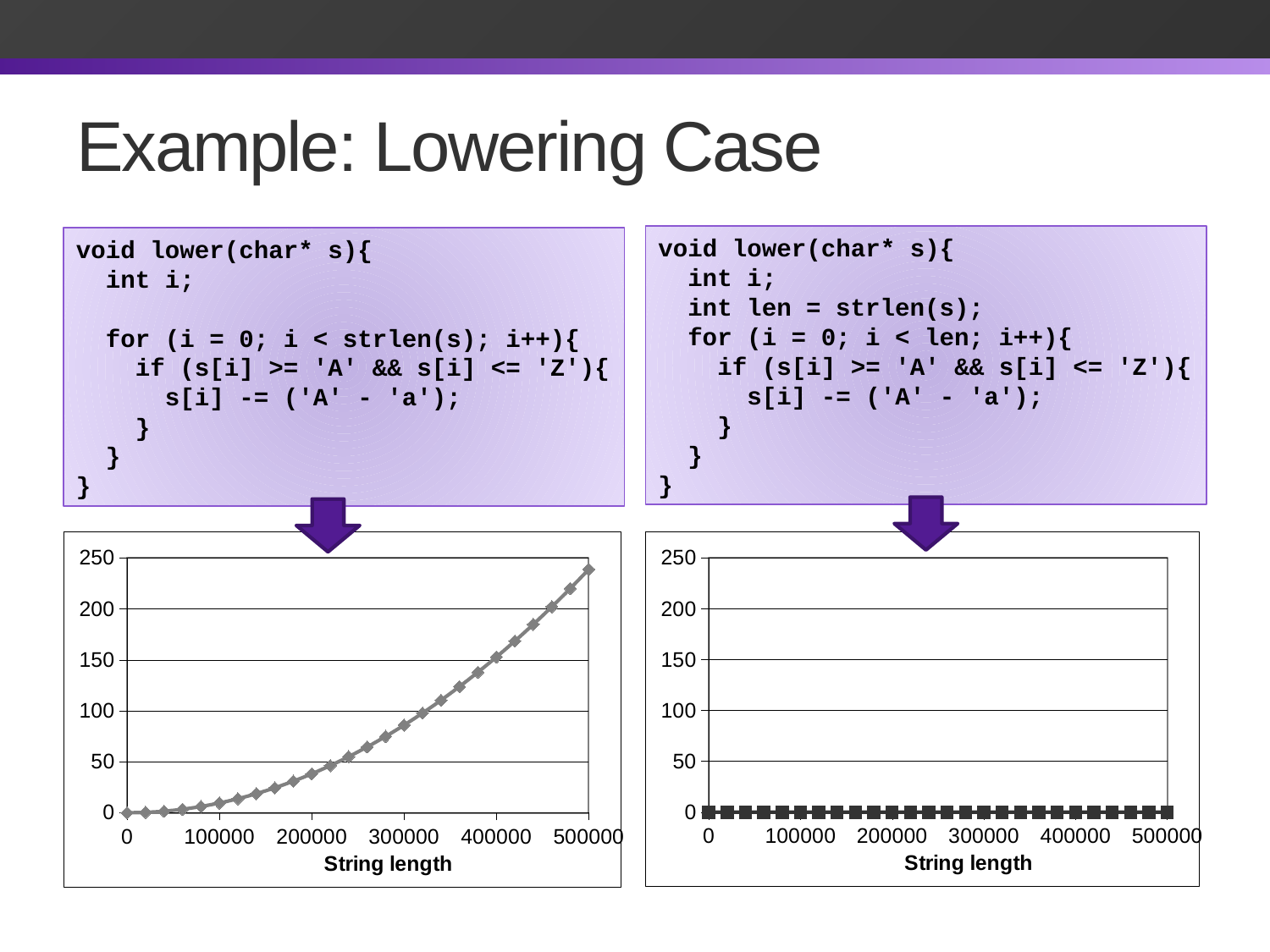
What kind of chart is the chart on the right of the slide? line chart In the chart on the right, do the values rise, fall, or stay flat as string length increases? stay flat What is the highest value shown on the y axis of the chart on the right? 250 In the chart on the left, is the value at string length 100000 greater or less than 50? less In the chart on the left, is the value at string length 500000 greater or less than 200? greater In the chart on the right, is the value at string length 500000 greater or less than 50? less In the chart on the left, do the values rise or fall as string length increases? rise What kind of chart is the chart on the left of the slide? line chart What is the x-axis title of the chart on the left? String length At string length 500000, which chart shows the larger value, the left chart or the right chart? the left chart